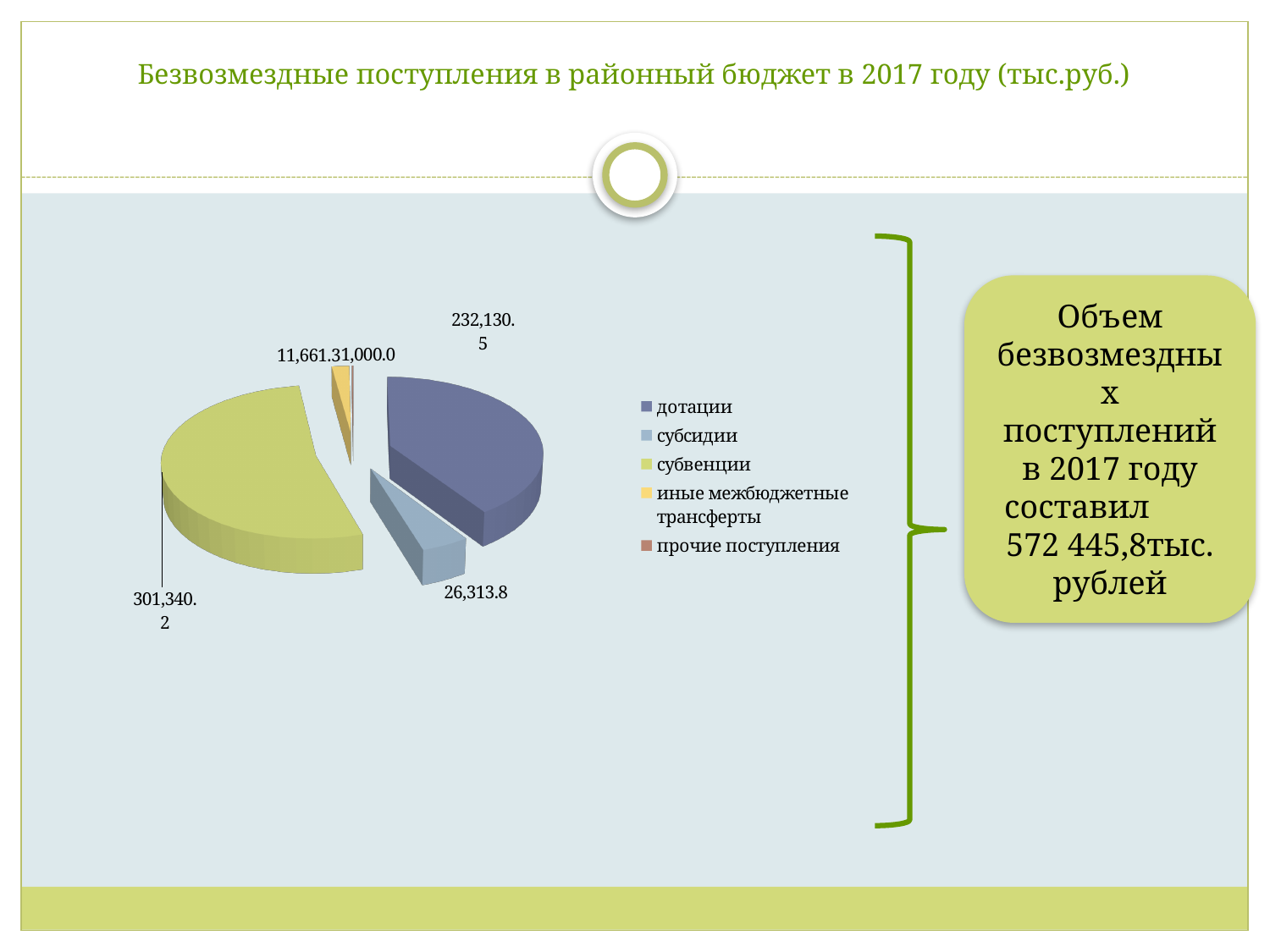
What is the value for дотации in the pie chart? 232,130.5 What is the value for субсидии in the pie chart? 26,313.8 Which is larger, дотации or субсидии? дотации What is the difference between субвенции and дотации? 69,209.7 What kind of chart is shown on the slide? pie chart What colour represents субвенции in the pie chart legend? green How many categories does the legend of the pie chart list? 5 What is the difference between дотации and субсидии? 205,816.7 Which category has the largest slice in the pie chart? субвенции According to the text box, what was the total volume of безвозмездные поступления in 2017? 572 445,8 тыс. рублей What is the value for субвенции in the pie chart? 301,340.2 What is the title of the slide containing the pie chart? Безвозмездные поступления в районный бюджет в 2017 году (тыс.руб.)